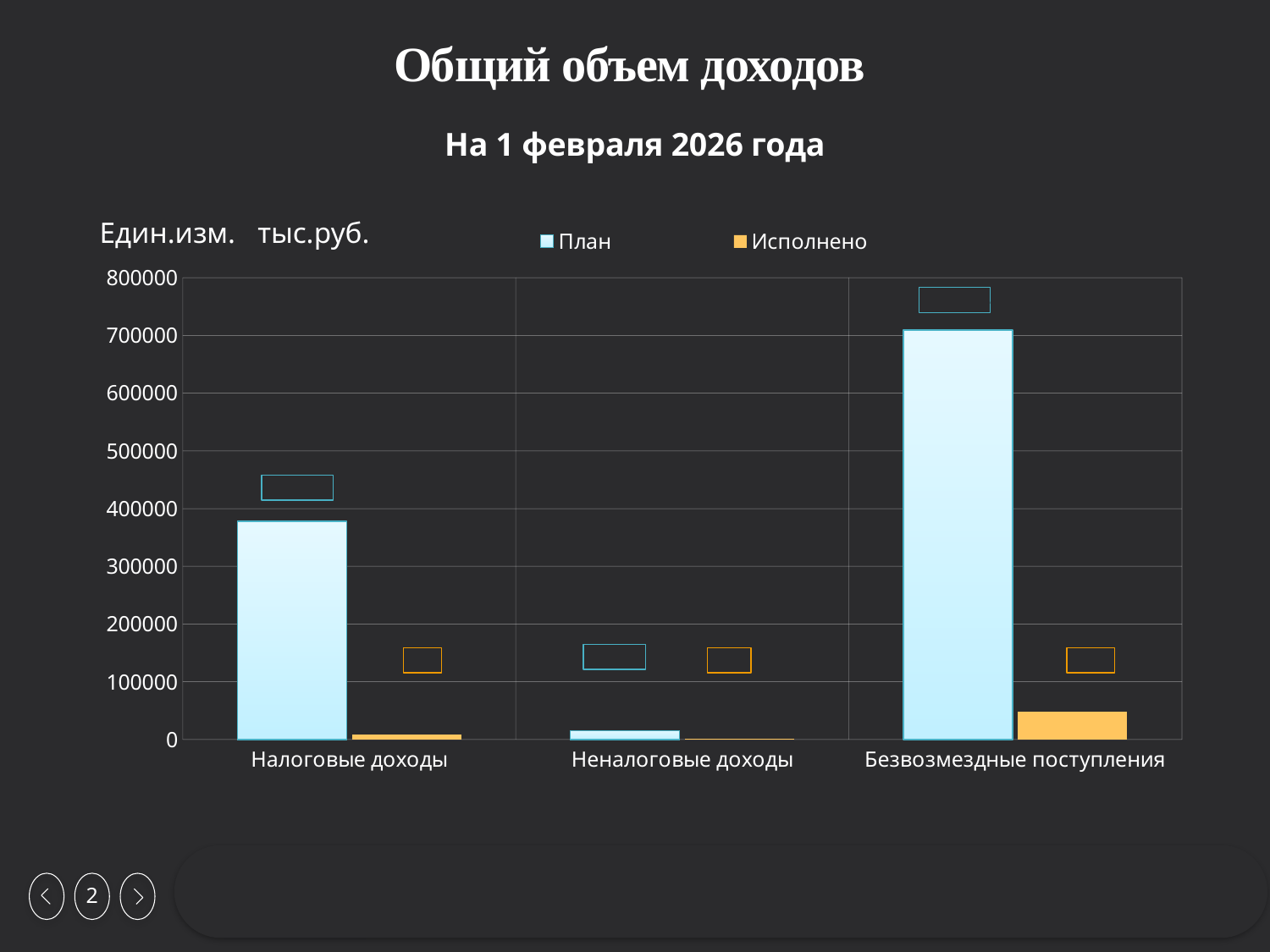
Which is larger for Налоговые доходы, the План value or the Исполнено value? План How many categories are shown on the x axis? 3 Is the План value for Налоговые доходы greater or less than 400000? less What kind of chart is shown on the slide? bar chart Which category has the highest План value? Безвозмездные поступления Which category has the lowest План value? Неналоговые доходы Is the План value for Безвозмездные поступления greater or less than 600000? greater What unit of measurement is stated on the slide for the chart values? тыс.руб. Is the Исполнено value for Безвозмездные поступления greater or less than 100000? less How many series does the legend list? 2 Which colour represents the Исполнено series in the legend? orange Which category has the highest Исполнено value? Безвозмездные поступления